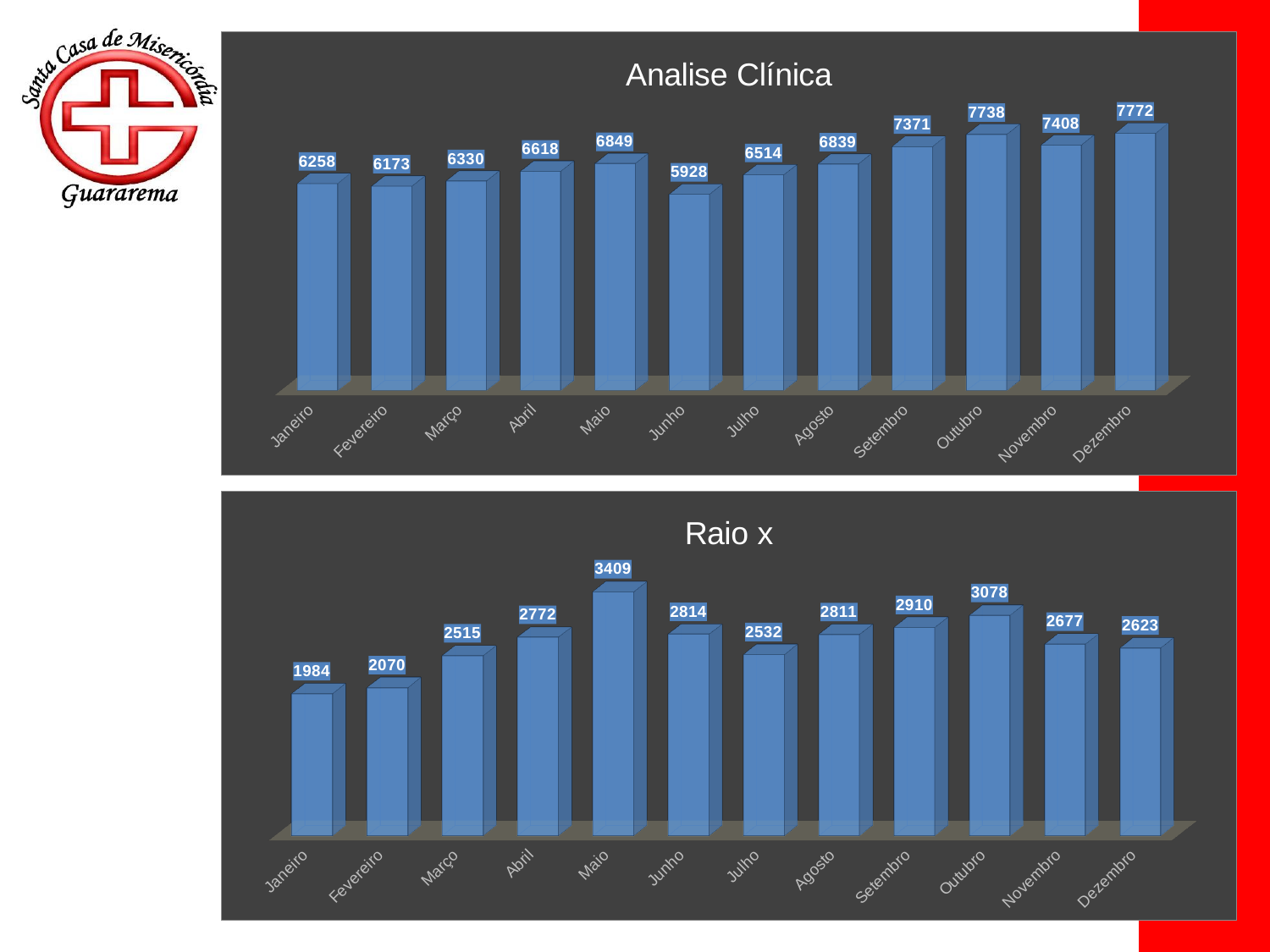
In the Raio x chart, which is larger, the value for Outubro or the value for Setembro? Outubro What kind of chart is the Analise Clínica chart? Bar chart In the Analise Clínica chart, which month has the highest value? Dezembro In the Analise Clínica chart, what is the value for Setembro? 7371 In the Analise Clínica chart, which month has the lowest value? Junho In the Raio x chart, which month has the highest value? Maio In the Raio x chart, what is the difference between the values for Maio and Janeiro? 1425 In the Raio x chart, what is the value for Abril? 2772 In the Raio x chart, which month has the lowest value? Janeiro How many months are shown in the Raio x chart? 12 In the Analise Clínica chart, what is the difference between the values for Dezembro and Janeiro? 1514 In the Analise Clínica chart, which is larger, the value for Maio or the value for Julho? Maio